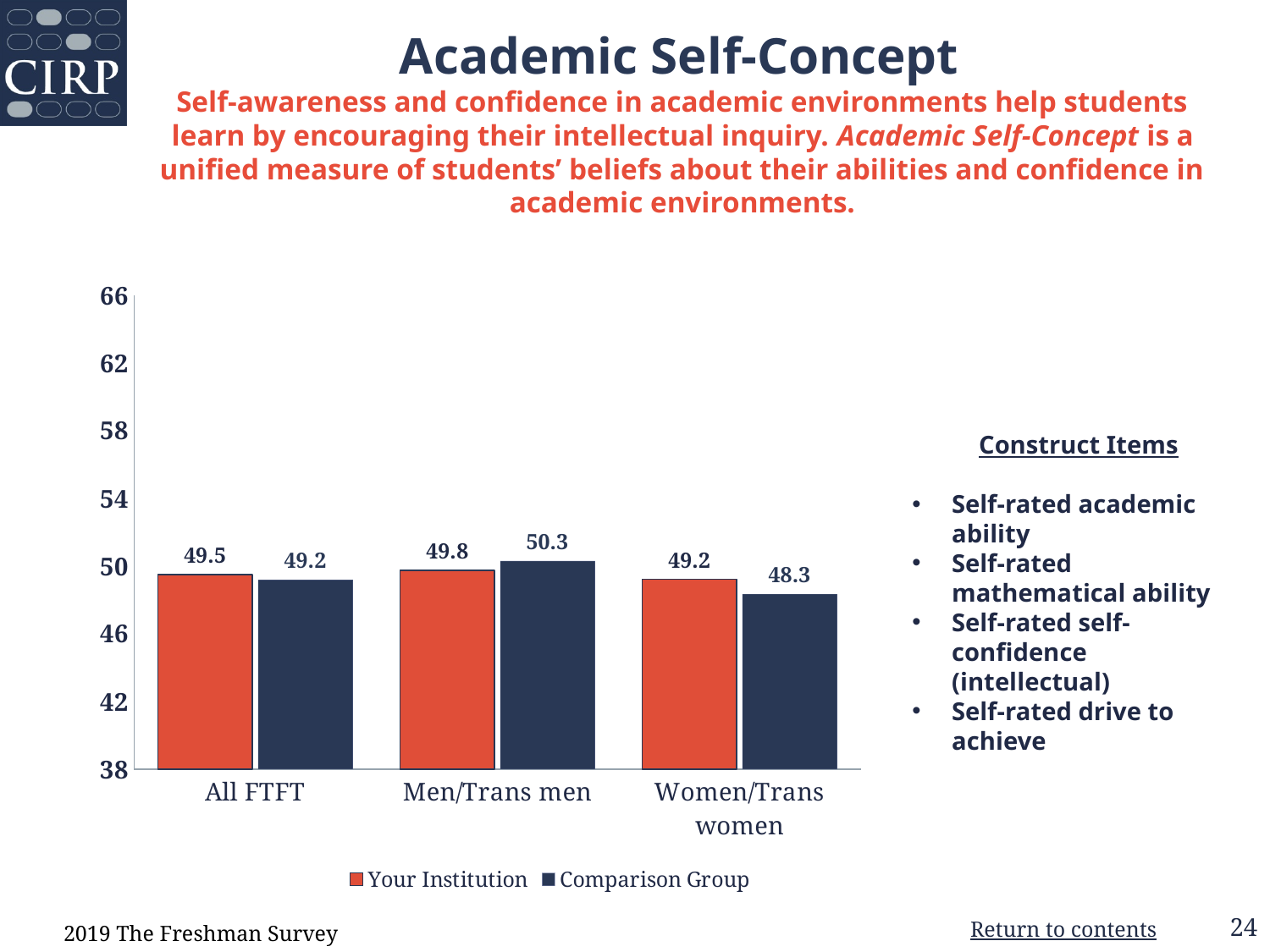
Which category has the highest Comparison Group value? Men/Trans men For Men/Trans men, which is larger: Your Institution or Comparison Group? Comparison Group What is the Your Institution value for Women/Trans women? 49.2 What is the difference between the Comparison Group values for Men/Trans men and Women/Trans women? 2.0 How many categories are shown on the x axis? 3 What is the difference between the Your Institution and Comparison Group values for Women/Trans women? 0.9 How many series does the legend list? 2 What is the Comparison Group value for Men/Trans men? 50.3 What is the Comparison Group value for Women/Trans women? 48.3 Which category has the lowest Comparison Group value? Women/Trans women Is the Comparison Group value for Women/Trans women greater or less than 50? less What is the Your Institution value for All FTFT? 49.5